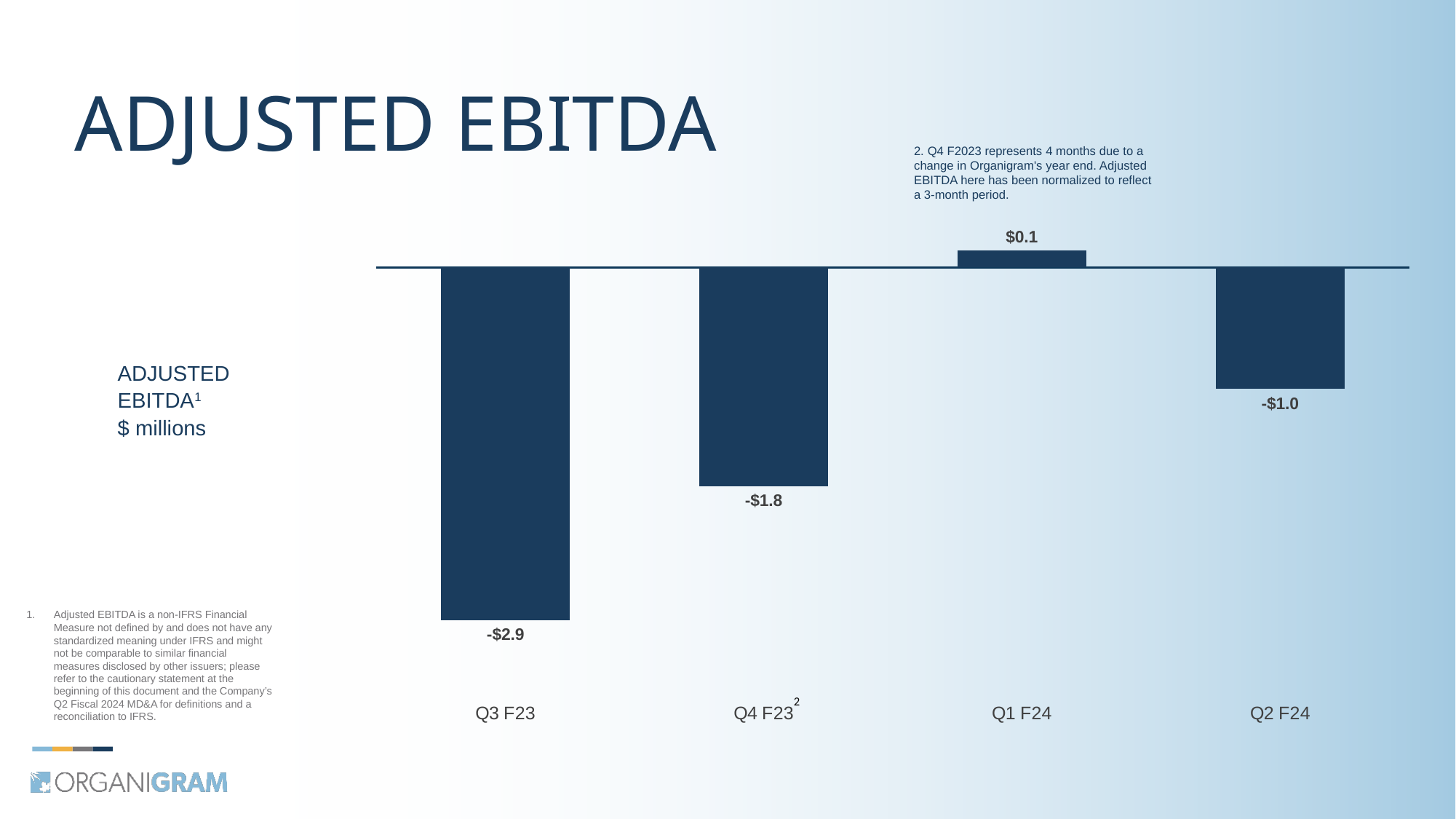
What is the Adjusted EBITDA value for Q1 F24? $0.1 Which quarter has the larger Adjusted EBITDA, Q4 F23 or Q2 F24? Q2 F24 Which quarter has the highest Adjusted EBITDA? Q1 F24 Does Adjusted EBITDA rise or fall from Q3 F23 to Q1 F24? Rise In what units are the Adjusted EBITDA values shown? $ millions What is the Adjusted EBITDA value for Q4 F23? -$1.8 What kind of chart is shown on the slide? Bar chart What is the Adjusted EBITDA value for Q2 F24? -$1.0 Which quarter has the lowest Adjusted EBITDA? Q3 F23 What is the Adjusted EBITDA value for Q3 F23? -$2.9 What is the difference between the Adjusted EBITDA for Q4 F23 and Q3 F23? $1.1 How many quarters are shown in the chart? 4